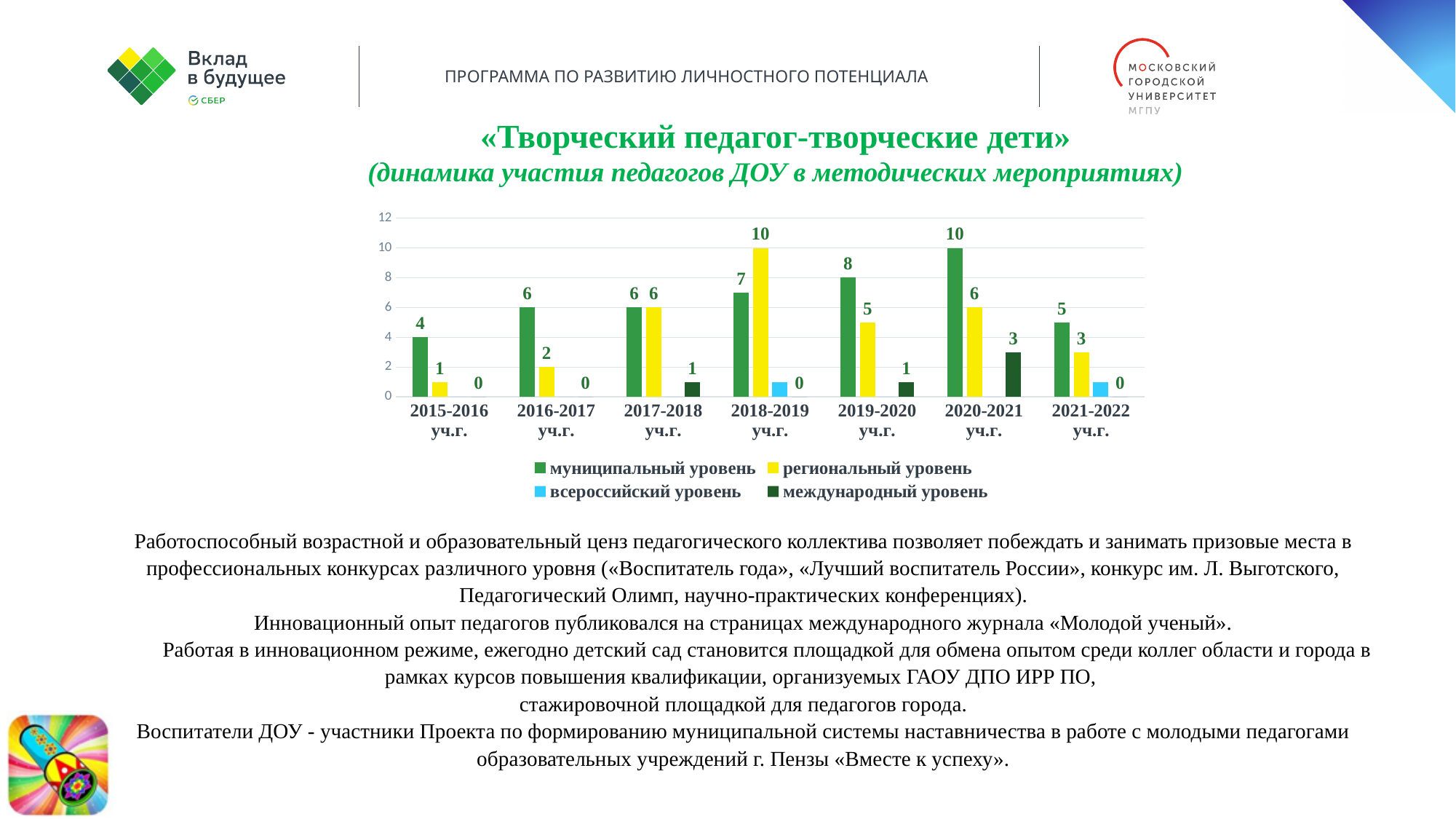
Is the value for региональный уровень in 2020-2021 уч.г. greater or less than 4? greater In which academic year is the value for муниципальный уровень the lowest? 2015-2016 уч.г. What is the value for всероссийский уровень in 2021-2022 уч.г.? 1 How many series does the chart legend list? 4 How many academic years are shown on the x axis of the chart? 7 In 2018-2019 уч.г., which is larger: муниципальный уровень or региональный уровень? региональный уровень What is the value for региональный уровень in 2018-2019 уч.г.? 10 What kind of chart is shown on the slide? bar chart What is the value for муниципальный уровень in 2020-2021 уч.г.? 10 What is the value for международный уровень in 2020-2021 уч.г.? 3 In 2019-2020 уч.г., what is the difference between муниципальный уровень and региональный уровень? 3 In which academic year is the value for муниципальный уровень the highest? 2020-2021 уч.г.